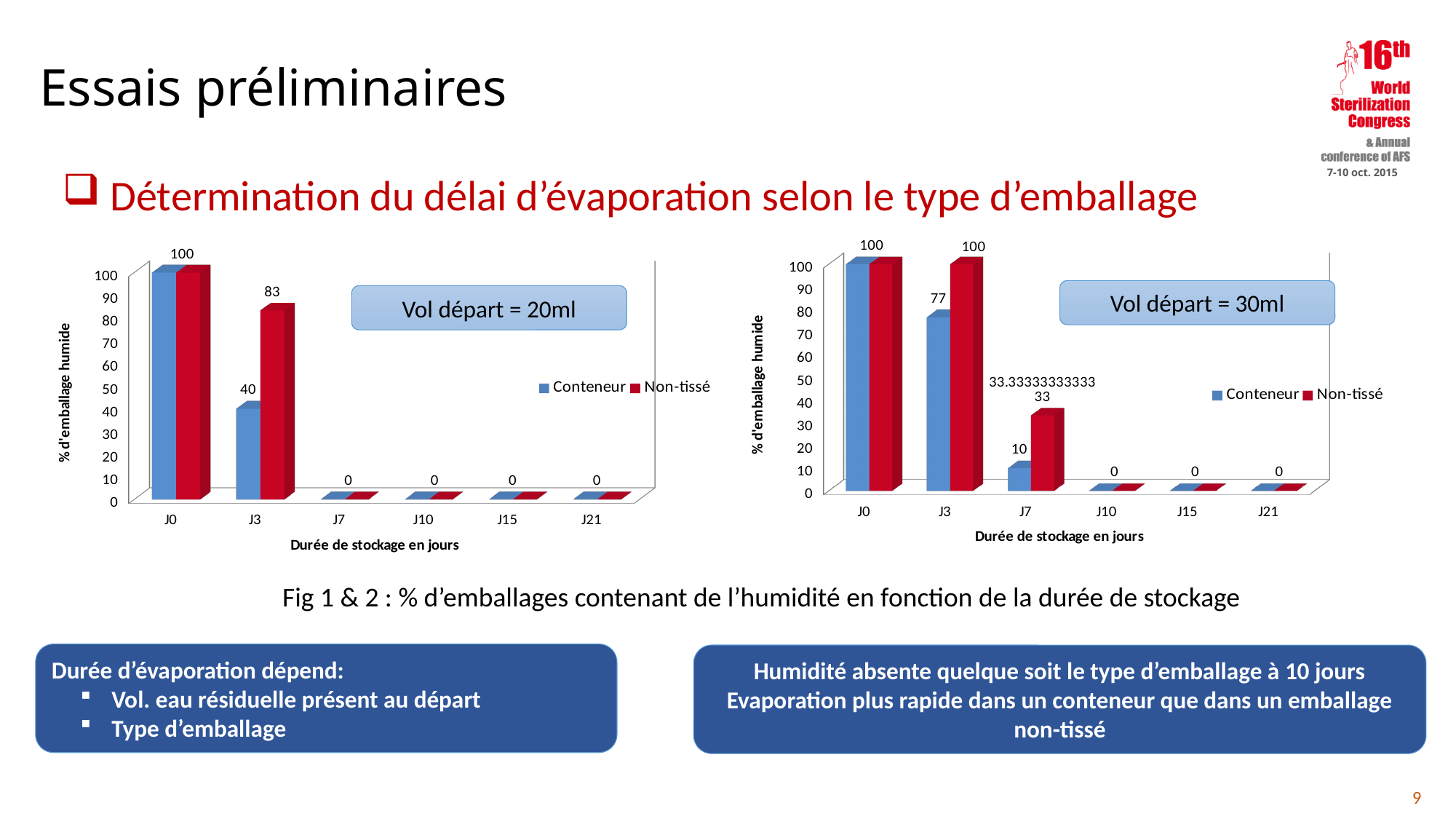
In the right chart (Vol départ = 30ml), what is the value for Conteneur at J7? 10 In the left chart (Vol départ = 20ml), what is the value for Conteneur at J3? 40 How many storage-duration categories are shown on the x axis of the left chart (Vol départ = 20ml)? 6 How many series does the legend of the right chart (Vol départ = 30ml) list? 2 In the left chart (Vol départ = 20ml), what is the value for Non-tissé at J3? 83 In the left chart (Vol départ = 20ml), what is the difference between the Non-tissé and Conteneur values at J3? 43 In the right chart (Vol départ = 30ml), is the value for Non-tissé at J7 greater or less than 20? greater In the right chart (Vol départ = 30ml), what is the value for Conteneur at J3? 77 In the right chart (Vol départ = 30ml), do the Conteneur values rise or fall from J0 to J7? Fall What is the x-axis title of the left chart (Vol départ = 20ml)? Durée de stockage en jours What type of chart is the left chart (Vol départ = 20ml)? Bar chart In the right chart (Vol départ = 30ml), which series has the larger value at J3, Conteneur or Non-tissé? Non-tissé